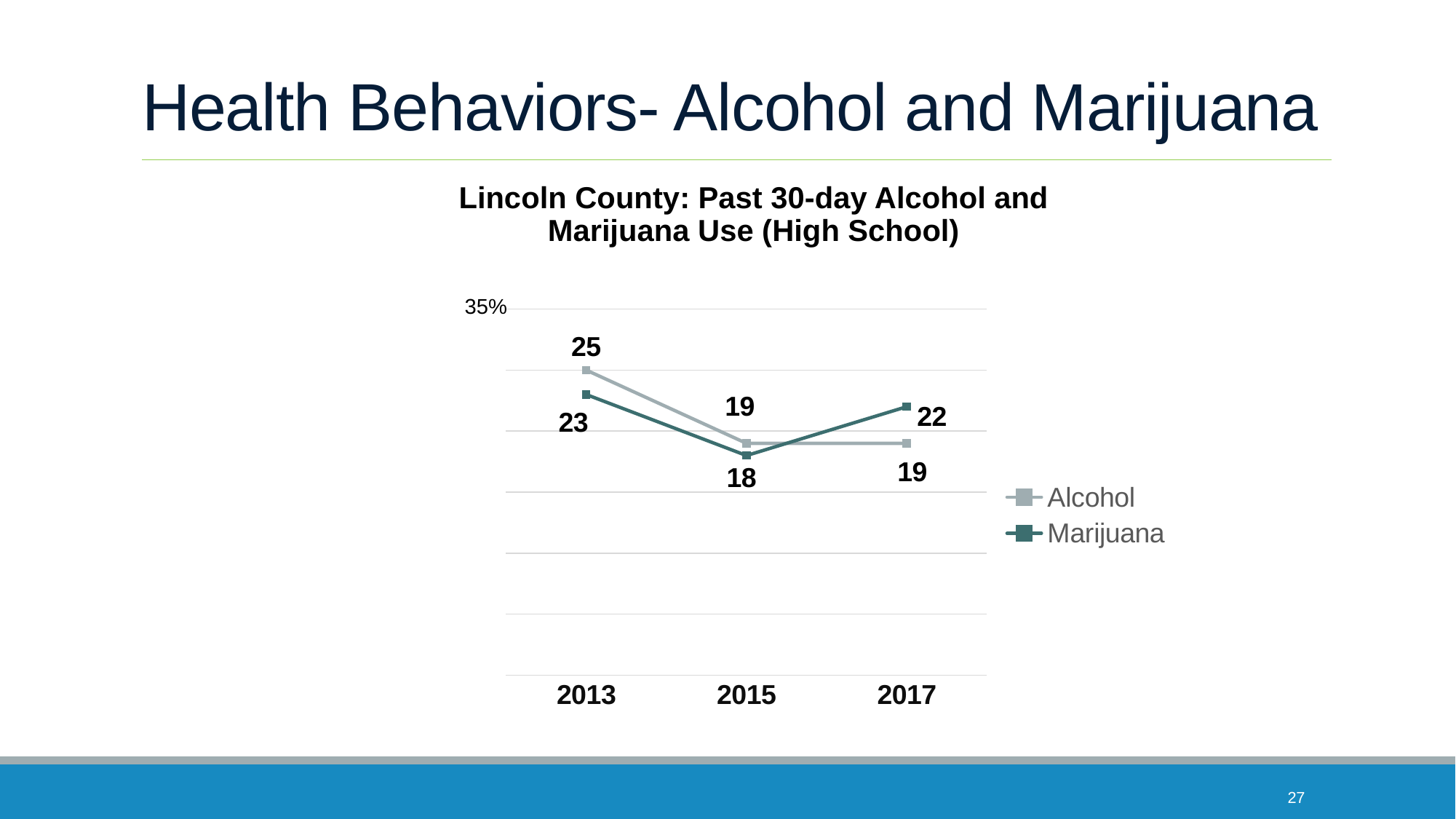
What is the Marijuana value for 2017? 22 What is the Alcohol value for 2013? 25 What is the difference between the Alcohol values for 2013 and 2015? 6 What is the title of the chart? Lincoln County: Past 30-day Alcohol and Marijuana Use (High School) Does the Alcohol series rise or fall from 2013 to 2015? fall What is the Marijuana value for 2015? 18 What kind of chart is shown? line chart In which year is the Marijuana value lowest? 2015 Which is larger in 2017, Alcohol or Marijuana? Marijuana How many series does the legend list? 2 In which year is the Alcohol value highest? 2013 How many years are shown on the x axis? 3